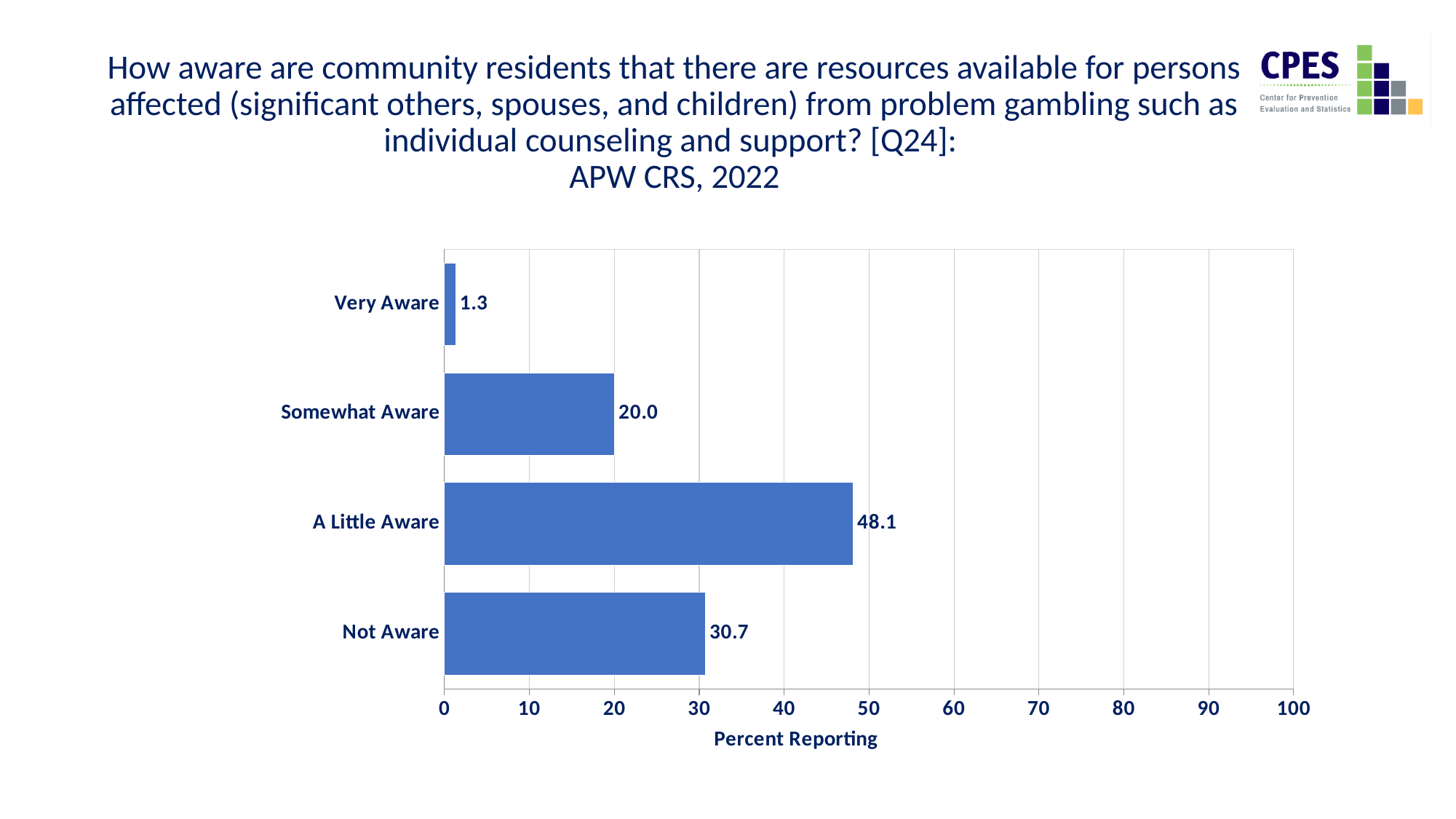
What is the label of the horizontal axis? Percent Reporting What is the difference between the values for 'Somewhat Aware' and 'Very Aware'? 18.7 What percent of respondents reported being 'A Little Aware'? 48.1 What is the value for 'Somewhat Aware'? 20.0 Which category has the highest percent reporting? A Little Aware What is the value for 'Very Aware'? 1.3 What percent reported being 'Not Aware'? 30.7 What kind of chart is shown on the slide? Bar chart Which category has the lowest percent reporting? Very Aware What is the difference between the values for 'A Little Aware' and 'Not Aware'? 17.4 How many categories are shown on the chart? 4 Which is larger, the value for 'Not Aware' or the value for 'Somewhat Aware'? Not Aware